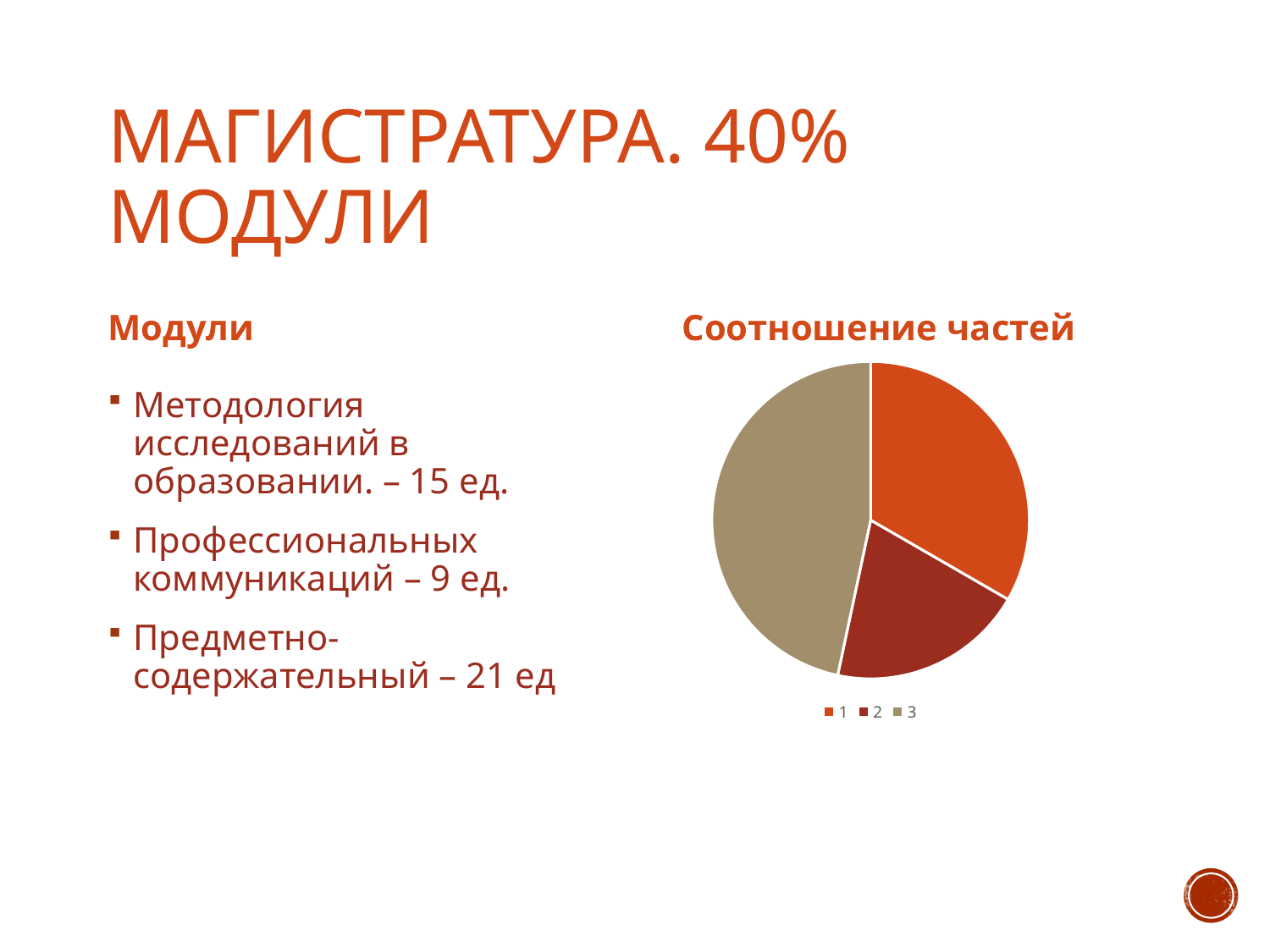
Which slice is larger in the pie chart, 3 or 1? 3 How many entries does the chart legend list? 3 What kind of chart is shown on the slide? pie chart Which slice of the pie chart is the smallest? 2 What is the title of the chart on the slide? Соотношение частей Which slice is larger in the pie chart, 2 or 3? 3 How many slices does the pie chart have? 3 Which slice is larger in the pie chart, 1 or 2? 1 Which slice of the pie chart is the largest? 3 What are the labels listed in the chart legend? 1, 2, 3